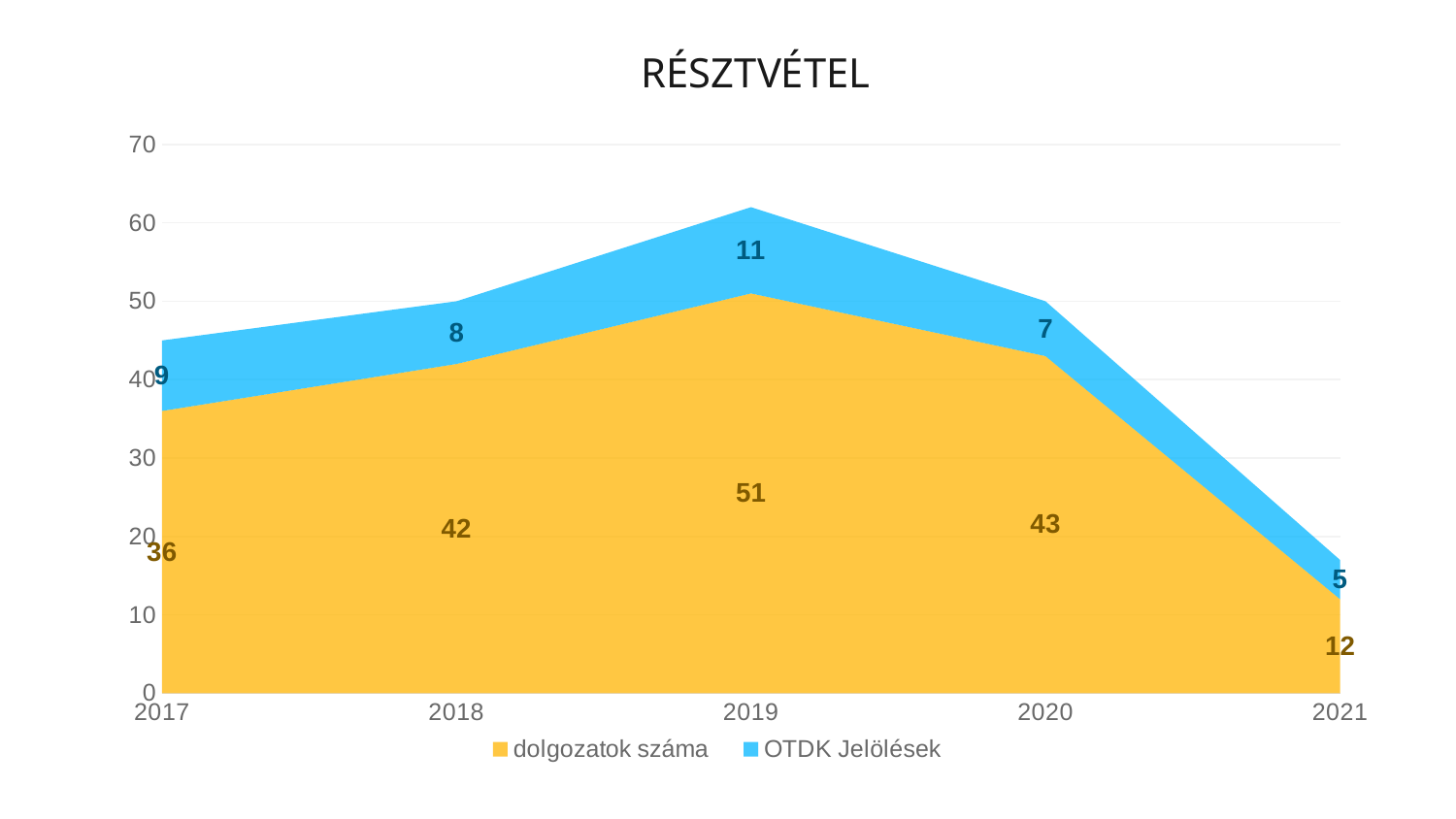
What is the combined total of 'dolgozatok száma' and 'OTDK Jelölések' in 2019? 62 What kind of chart is shown on the slide? stacked area chart How many series does the legend list? 2 How many years are shown on the x axis? 5 What is the title of the chart? RÉSZTVÉTEL Which is larger: 'OTDK Jelölések' in 2018 or in 2020? 2018 What is the value of 'OTDK Jelölések' in 2017? 9 In which year is 'dolgozatok száma' highest? 2019 What is the difference between 'dolgozatok száma' in 2019 and in 2020? 8 What is the value of 'dolgozatok száma' in 2019? 51 In which year is 'OTDK Jelölések' lowest? 2021 What is the value of 'dolgozatok száma' in 2021? 12